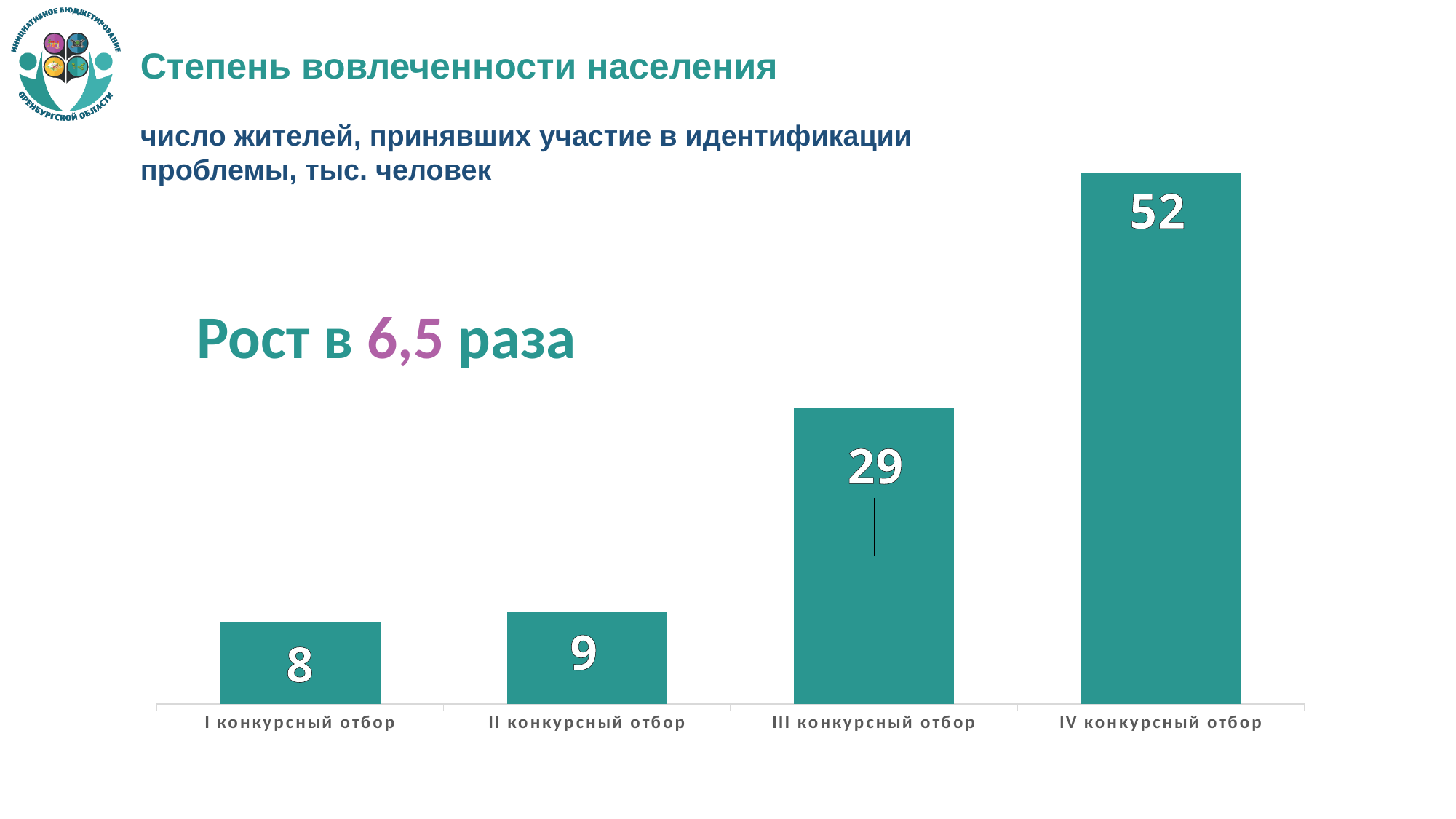
How many categories are shown on the chart? 4 Do the values rise or fall from I конкурсный отбор to IV конкурсный отбор? rise What is the value for I конкурсный отбор? 8 What is the value for II конкурсный отбор? 9 What is the value for III конкурсный отбор? 29 What is the value for IV конкурсный отбор? 52 What is the difference between the values for IV конкурсный отбор and III конкурсный отбор? 23 Which category has the lowest value? I конкурсный отбор Which is larger, the value for III конкурсный отбор or the value for II конкурсный отбор? III конкурсный отбор What kind of chart is shown on the slide? bar chart What is the difference between the values for III конкурсный отбор and I конкурсный отбор? 21 Which category has the highest value? IV конкурсный отбор